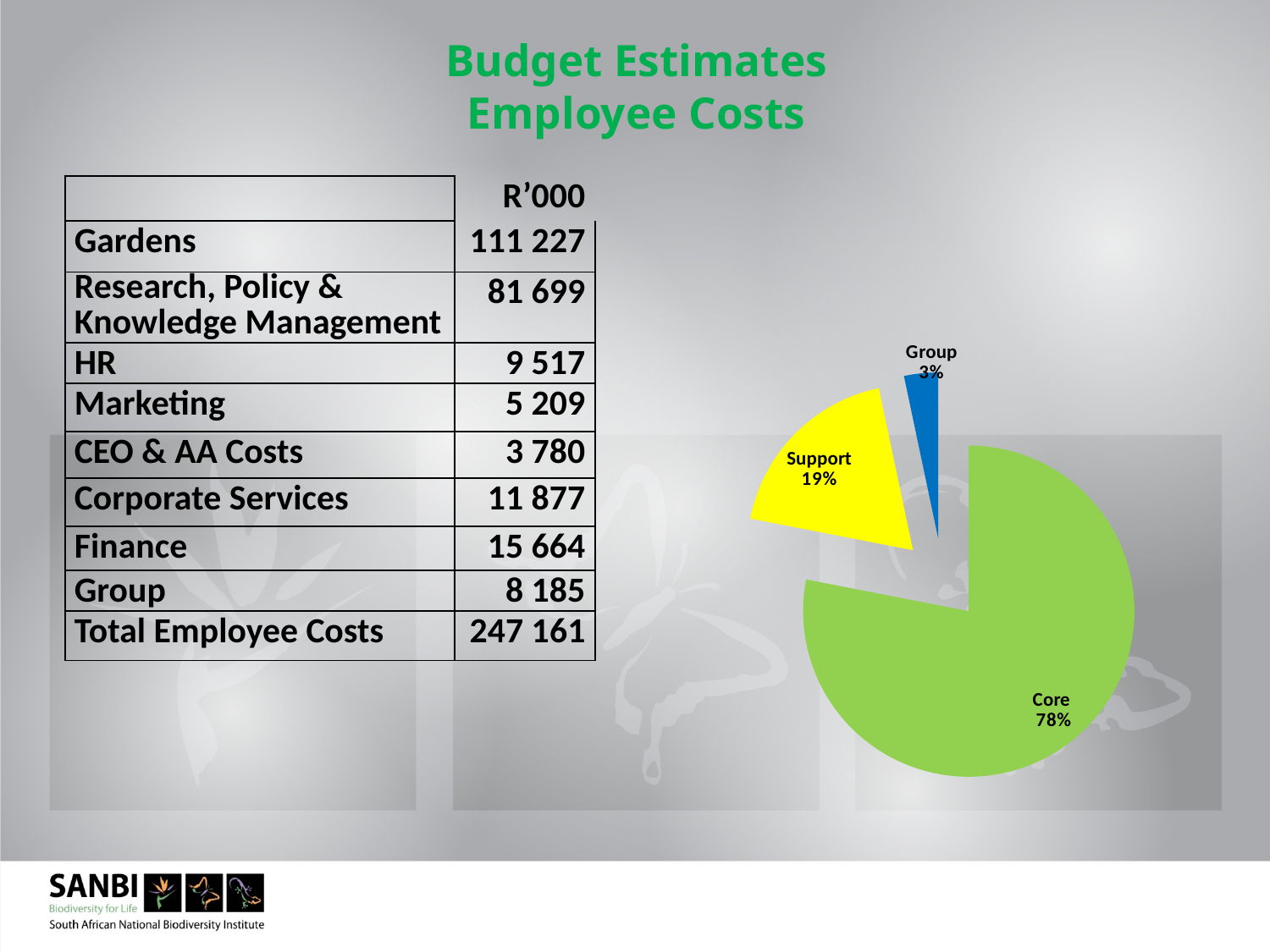
What colour is the Support slice of the pie chart? yellow What share of the pie chart does Support represent? 19% How many slices does the pie chart have? 3 What share of the pie chart does Group represent? 3% What is the difference in percentage points between the Support and Group slices of the pie chart? 16 What colour is the Core slice of the pie chart? green Which slice of the pie chart is the largest? Core Which slice of the pie chart is the smallest? Group What kind of chart is shown on the slide? pie chart What is the difference in percentage points between the Core and Support slices of the pie chart? 59 What share of the pie chart does Core represent? 78% In the pie chart, which is larger, Support or Group? Support